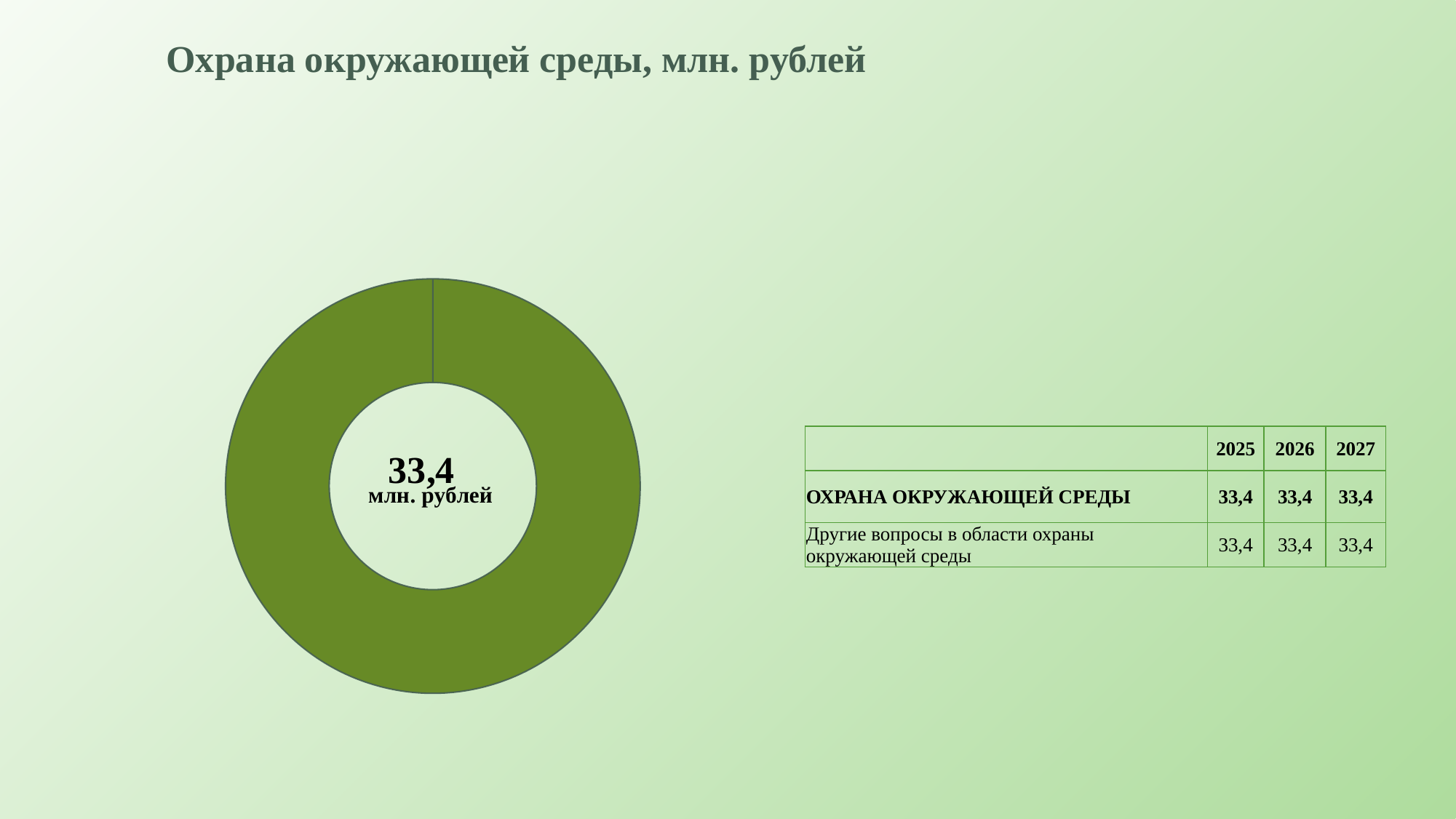
What value is printed in the centre of the doughnut chart? 33,4 What share of the doughnut chart does the single slice take up? 100% Is the value shown in the centre of the doughnut chart greater or less than 30? greater Is the value shown in the centre of the doughnut chart greater or less than 40? less What kind of chart is shown on the slide? doughnut chart How many slices does the doughnut chart have? 1 What unit is printed under the value in the centre of the doughnut chart? млн. рублей What colour is the slice of the doughnut chart? green